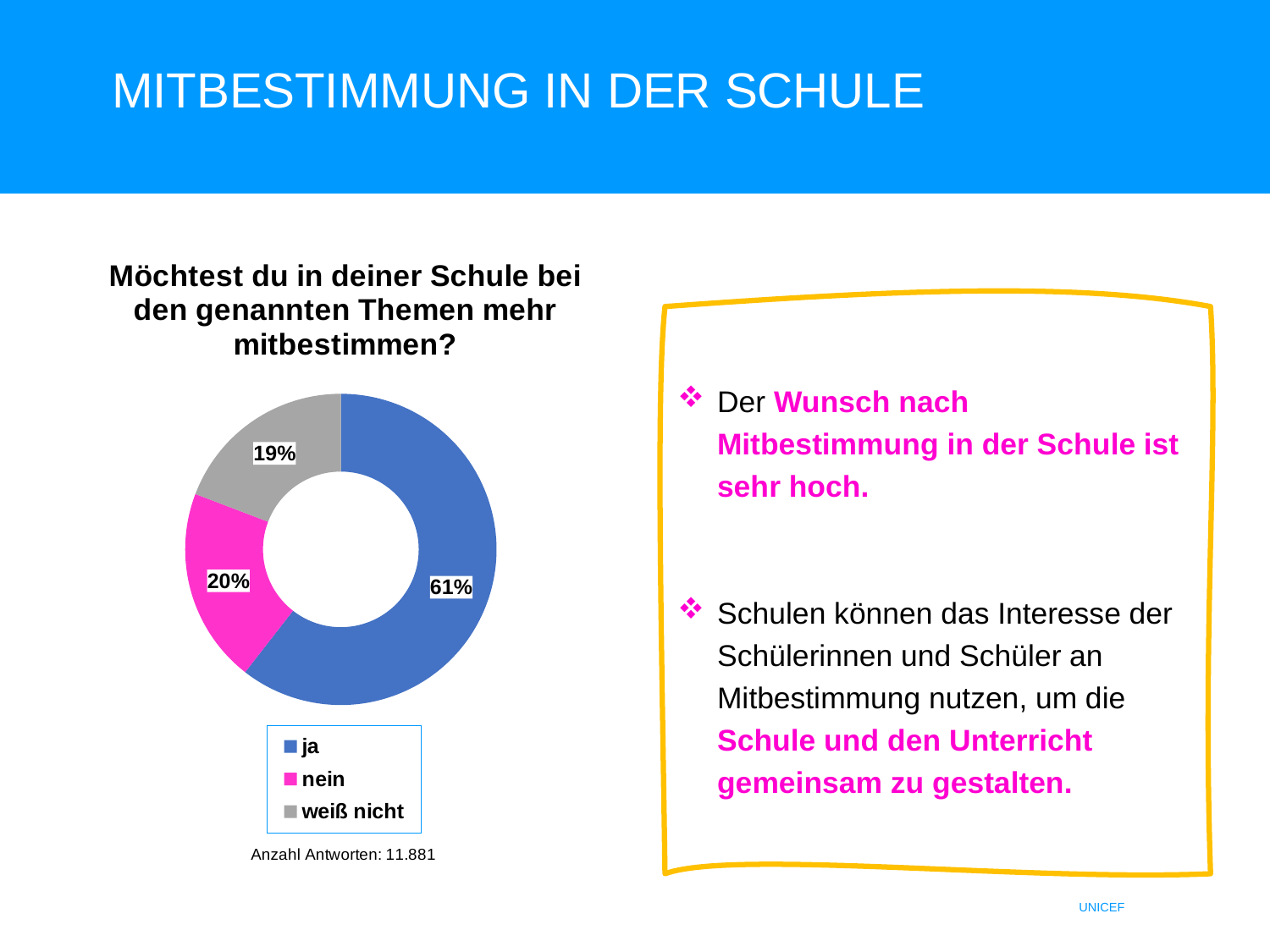
What is the combined share of "nein" and "weiß nicht"? 39% What kind of chart is shown on the slide? Doughnut (pie) chart How many categories does the chart show? 3 What percentage of respondents answered "weiß nicht"? 19% What percentage of respondents answered "ja"? 61% Which answer category has the largest share of the chart? ja How many responses (Anzahl Antworten) does the chart note state? 11.881 Which is larger, the share for "ja" or the share for "weiß nicht"? ja What is the title of the chart? Möchtest du in deiner Schule bei den genannten Themen mehr mitbestimmen? What is the difference in percentage points between "ja" and "nein"? 41 Which answer category has the smallest share of the chart? weiß nicht What percentage of respondents answered "nein"? 20%